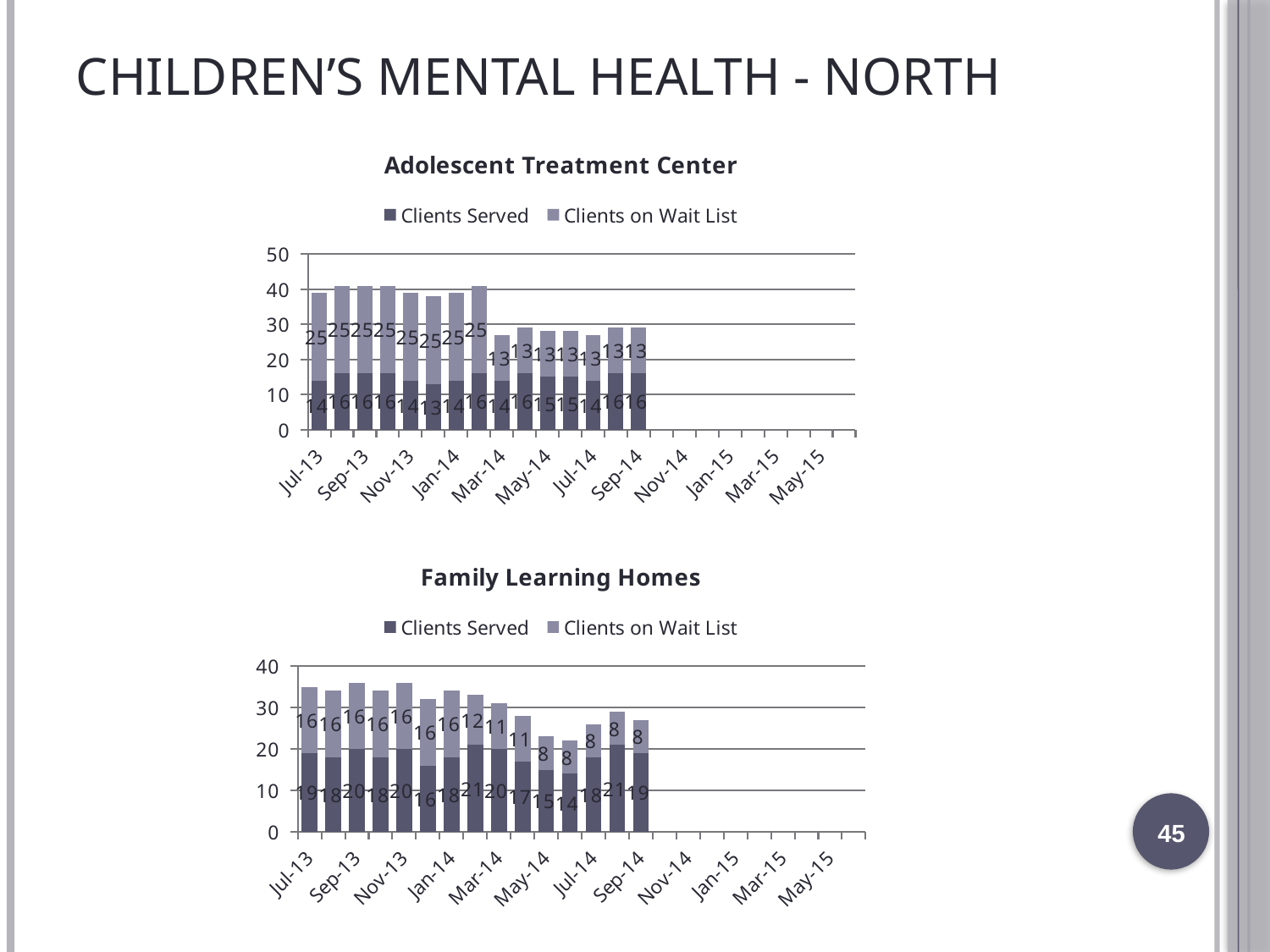
In the Adolescent Treatment Center chart, what is the difference between the wait list value in Jan-14 and the wait list value in Mar-14? 12 In the Adolescent Treatment Center chart, how many clients were served in Sep-14? 16 In the Adolescent Treatment Center chart, how many clients were on the wait list in Jul-13? 25 In the Adolescent Treatment Center chart, how many clients were on the wait list in May-14? 13 In the Adolescent Treatment Center chart, what is the total height of the stacked bar for Jul-13 (clients served plus clients on wait list)? 39 In the Family Learning Homes chart, how many clients were served in Jul-13? 19 In the Family Learning Homes chart, how many clients were on the wait list in Sep-14? 8 In the Family Learning Homes chart, what is the total height of the stacked bar for May-14 (clients served plus clients on wait list)? 23 In the Adolescent Treatment Center chart, how many series does the legend list? 2 In the Family Learning Homes chart, which is larger: the number of clients on the wait list in Jul-13 or in Jul-14? Jul-13 In the Family Learning Homes chart, is the total stacked bar for Sep-13 greater or less than 30? greater What type of chart is the Family Learning Homes chart? Stacked bar chart